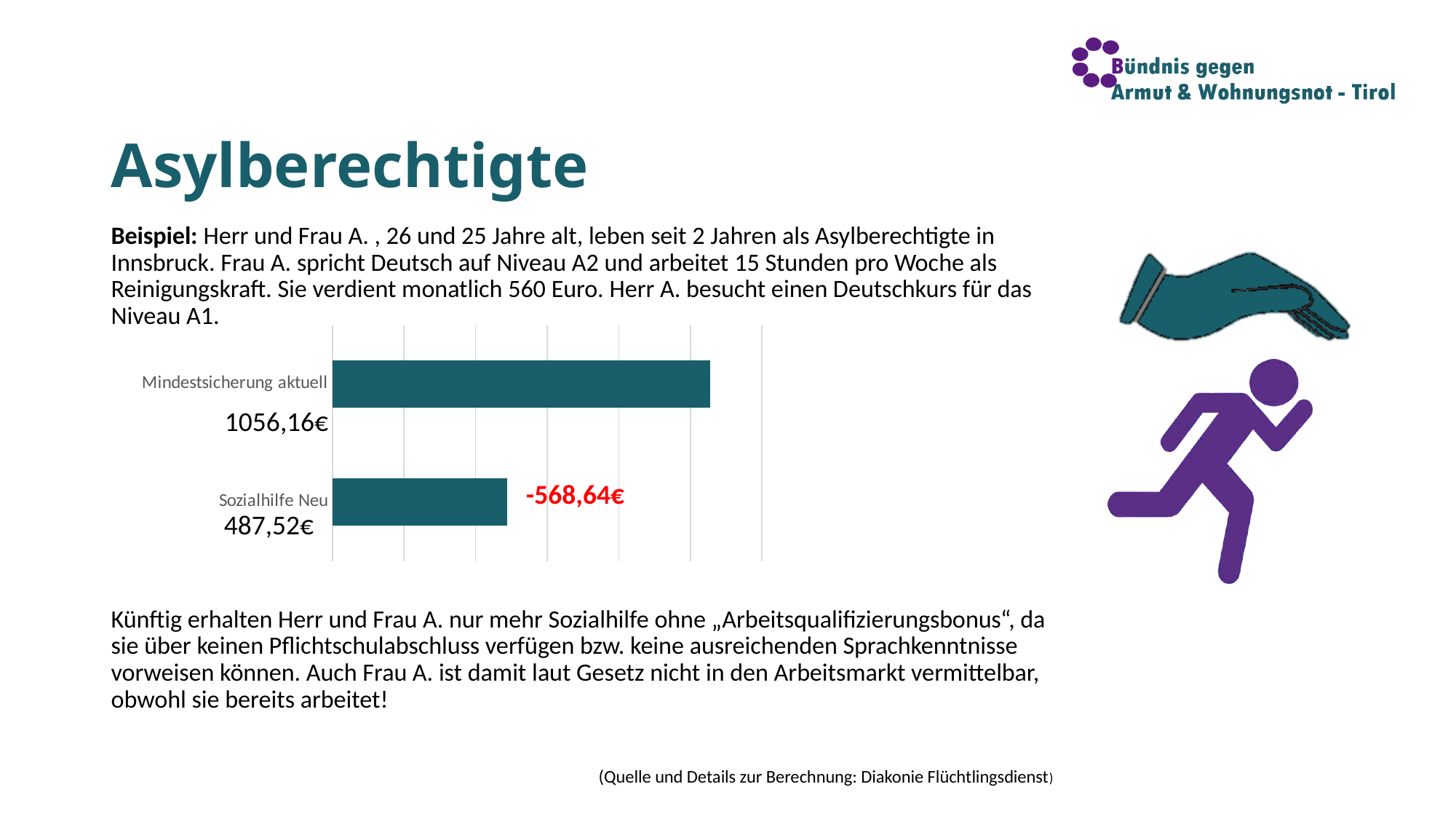
Which category has the highest value in the bar chart? Mindestsicherung aktuell What is the value shown for Mindestsicherung aktuell? 1056,16€ What kind of chart is shown on the slide? bar chart How many categories does the bar chart show? 2 What colour is the difference label -568,64€ printed in? red What is the difference between Mindestsicherung aktuell and Sozialhilfe Neu as printed on the chart? -568,64€ Which category has the lowest value in the bar chart? Sozialhilfe Neu By how much is Sozialhilfe Neu lower than Mindestsicherung aktuell? 568,64€ Are the bars in the chart horizontal or vertical? horizontal What is the value shown for Sozialhilfe Neu? 487,52€ Which category has the higher value, Mindestsicherung aktuell or Sozialhilfe Neu? Mindestsicherung aktuell